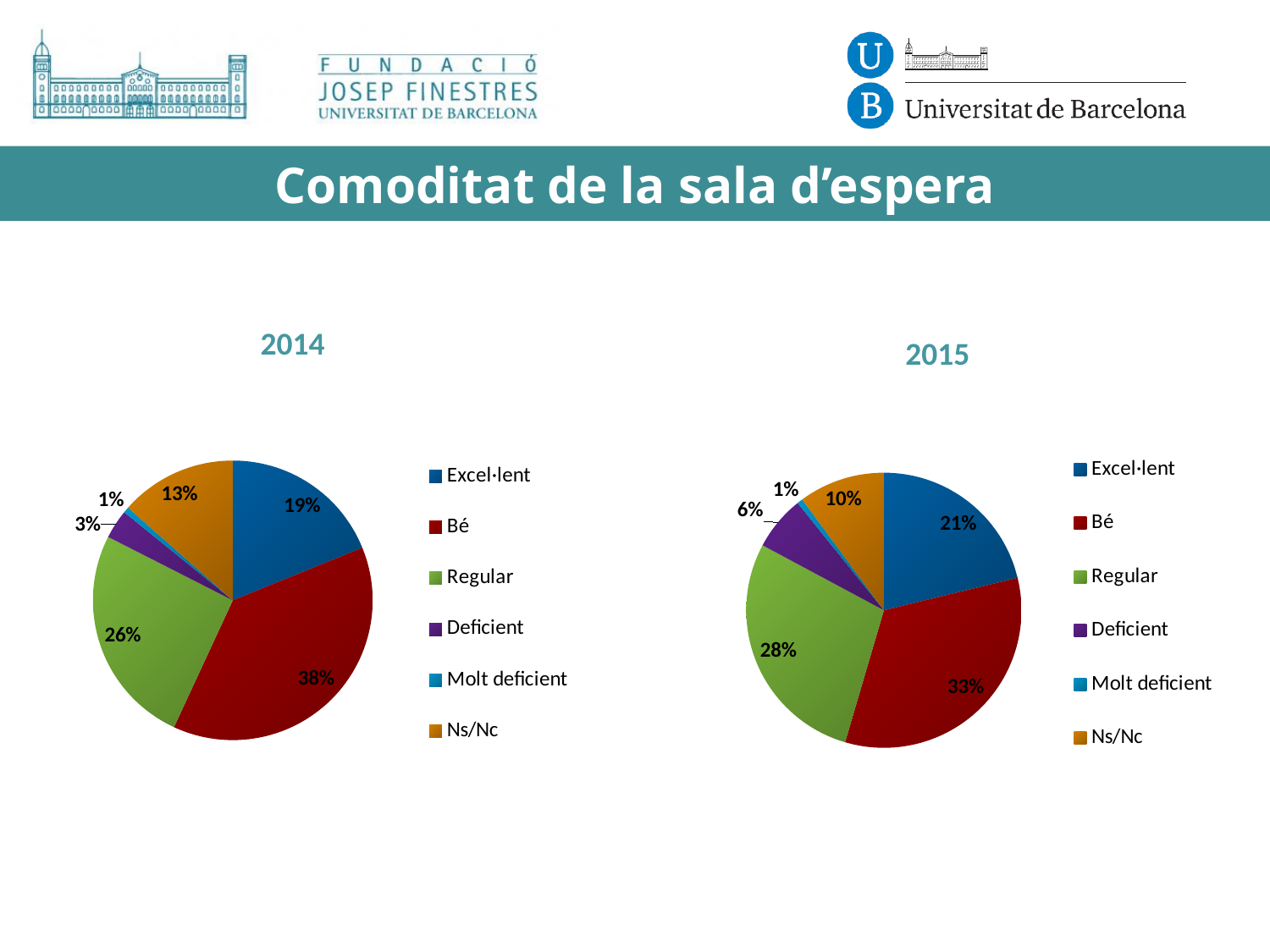
In the 2014 pie chart, what share does Ns/Nc have? 13% In the 2015 pie chart, what colour is the Regular slice? Green In the 2015 pie chart, what share does Regular have? 28% In the 2015 pie chart, what share does Deficient have? 6% In the 2015 pie chart, what is the difference between the Bé and Excel·lent shares? 12% What kind of chart is the 2014 chart? Pie chart In the 2014 pie chart, what share does Bé have? 38% In the 2014 pie chart, which is larger, Regular or Excel·lent? Regular In the 2014 pie chart, what is the combined share of Excel·lent and Bé? 57% In the 2015 pie chart, which category has the smallest slice? Molt deficient In the 2014 pie chart, which category has the largest slice? Bé How many categories does the legend of the 2015 pie chart list? 6